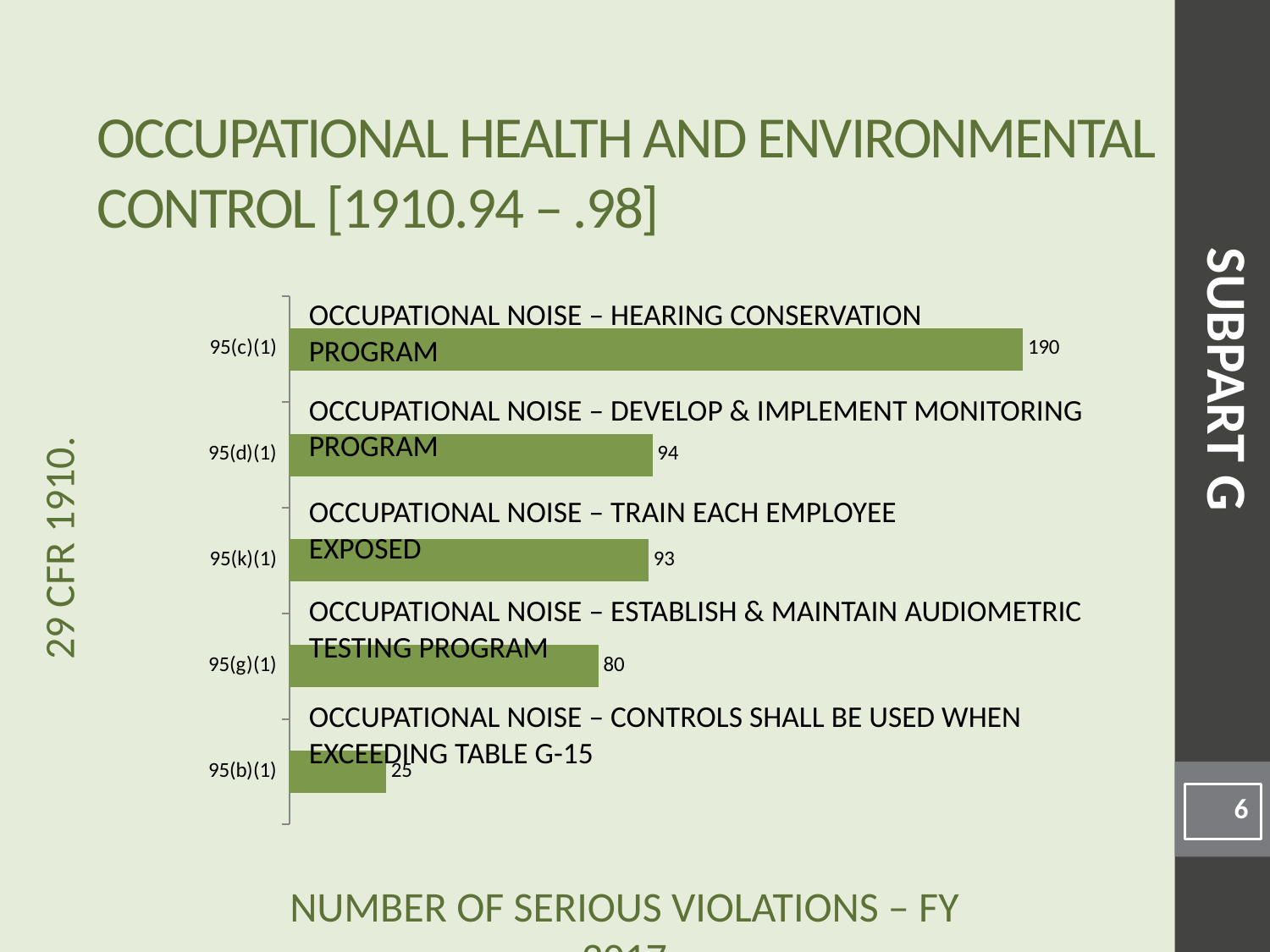
What is the number of serious violations for 95(c)(1)? 190 Which category has the highest number of serious violations? 95(c)(1) Which category has the lowest number of serious violations? 95(b)(1) What is the difference between the values for 95(g)(1) and 95(b)(1)? 55 What is the number of serious violations for 95(d)(1)? 94 How many categories are shown in the chart? 5 What is the number of serious violations for 95(b)(1)? 25 What is the difference between the values for 95(c)(1) and 95(d)(1)? 96 What is the number of serious violations for 95(g)(1)? 80 What kind of chart is shown on the slide? Bar chart Which has a larger value, 95(k)(1) or 95(g)(1)? 95(k)(1)